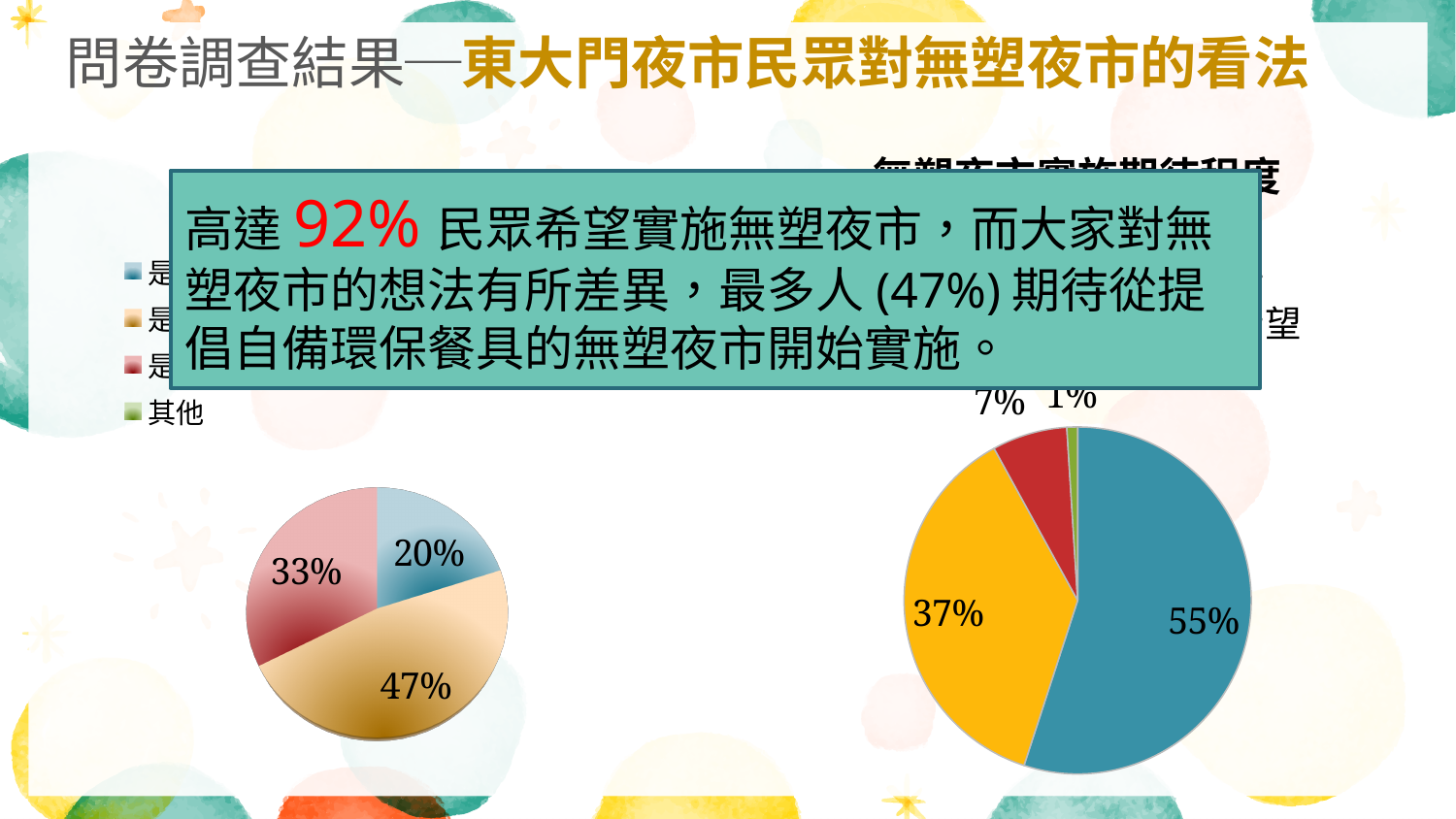
In the pie chart on the left, what is the value of the blue slice? 20% In the pie chart on the left, what is the value of the largest slice? 47% What kind of chart is the chart on the right of the slide? pie chart How many slices in the pie chart on the right have a printed percentage label? 4 In the pie chart on the left, what is the difference between the 47% slice and the 33% slice? 14 percentage points In the pie chart on the right, what is the value of the smallest labelled slice? 1% How many entries does the legend of the pie chart on the left list? 4 In the pie chart on the right, what is the value of the largest slice? 55% What kind of chart is the chart on the left of the slide? pie chart In the pie chart on the left, which is larger: the blue slice or the red slice? the red slice In the pie chart on the right, what is the value of the yellow slice? 37% In the pie chart on the right, what is the difference between the 55% slice and the 37% slice? 18 percentage points